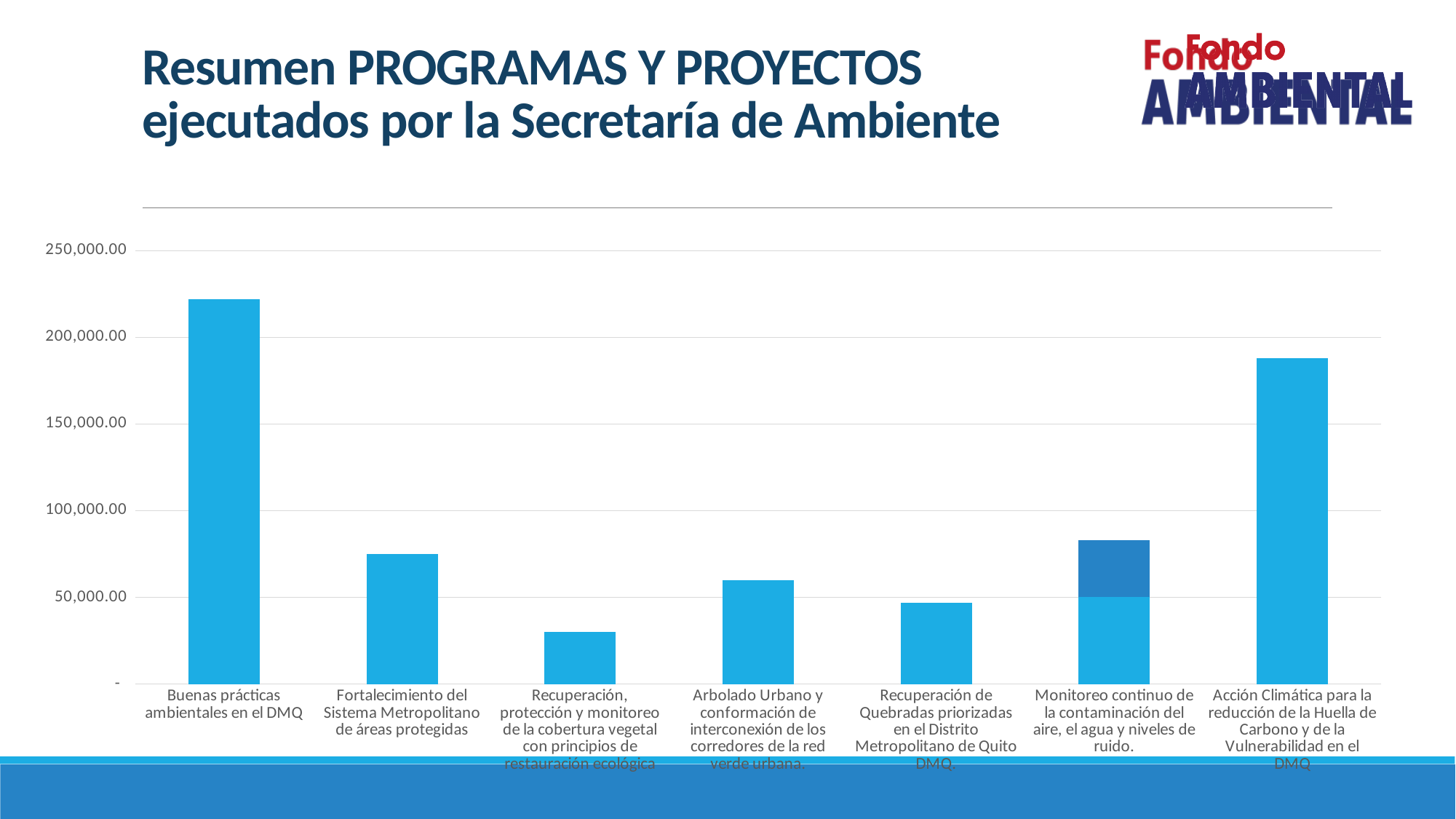
Which is larger: the value for Acción Climática para la reducción de la Huella de Carbono y de la Vulnerabilidad en el DMQ or the value for Buenas prácticas ambientales en el DMQ? Buenas prácticas ambientales en el DMQ How many categories are shown on the x axis of the chart? 7 Which category has the highest bar in the chart? Buenas prácticas ambientales en el DMQ Which is larger: the value for Fortalecimiento del Sistema Metropolitano de áreas protegidas or the value for Arbolado Urbano y conformación de interconexión de los corredores de la red verde urbana? Fortalecimiento del Sistema Metropolitano de áreas protegidas Is the value for Recuperación de Quebradas priorizadas en el Distrito Metropolitano de Quito DMQ greater or less than 50,000.00? less What kind of chart is shown on the slide? bar chart Which category has the lowest bar in the chart? Recuperación, protección y monitoreo de la cobertura vegetal con principios de restauración ecológica Is the value for Acción Climática para la reducción de la Huella de Carbono y de la Vulnerabilidad en el DMQ greater or less than 200,000.00? less Is the value for Buenas prácticas ambientales en el DMQ greater or less than 200,000.00? greater What is the title of the slide containing the chart? Resumen PROGRAMAS Y PROYECTOS ejecutados por la Secretaría de Ambiente